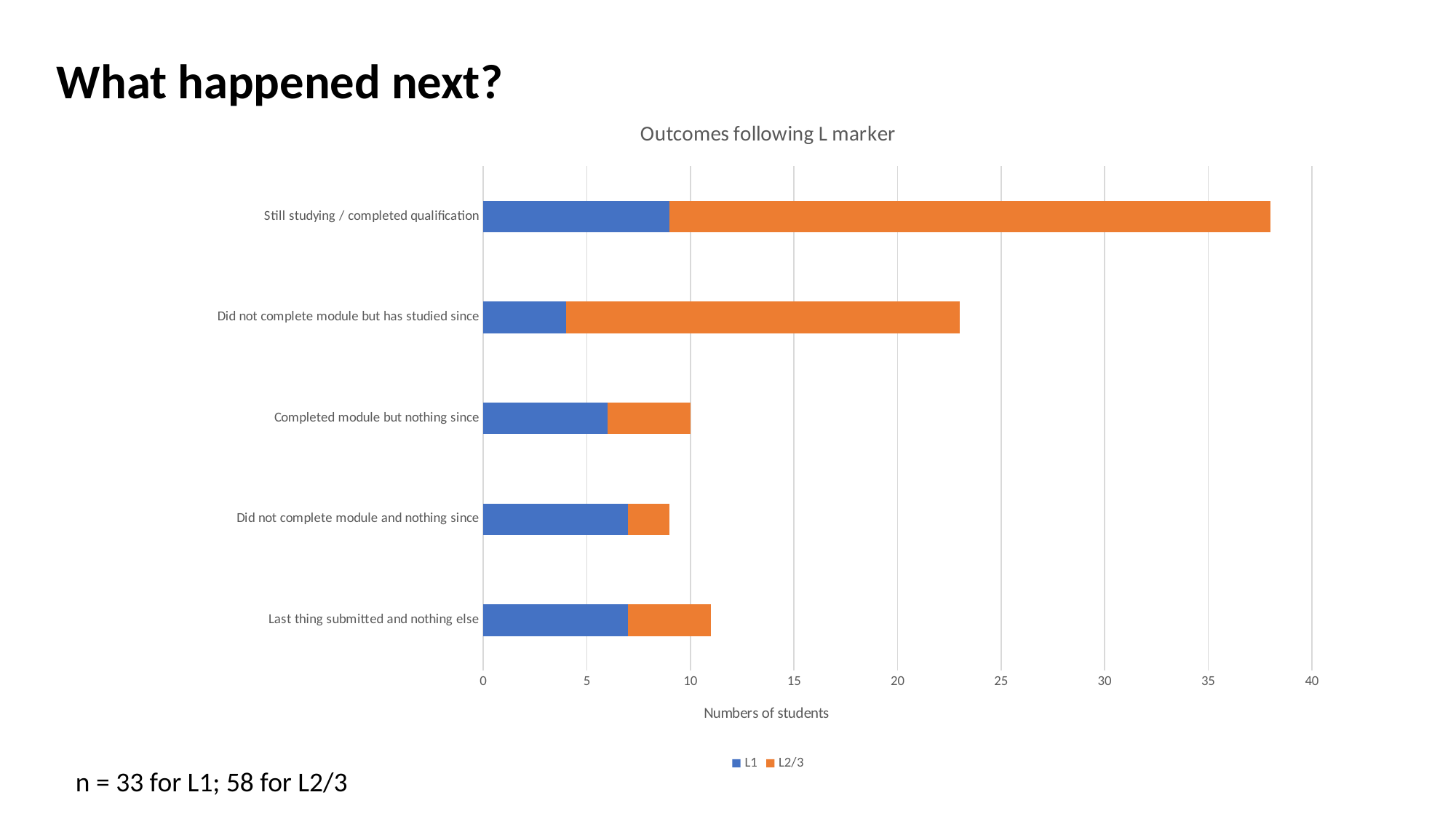
What kind of chart is shown on the slide? bar chart How many series does the legend list? 2 Which outcome category has the highest total number of students? Still studying / completed qualification What is the label on the horizontal axis of the chart? Numbers of students Is the total value for 'Still studying / completed qualification' greater or less than 35? greater How many outcome categories are plotted on the chart? 5 Is the L1 value for 'Did not complete module but has studied since' greater or less than 5? less Is the total value for 'Completed module but nothing since' greater or less than 15? less What is the title of the chart? Outcomes following L marker Which series is larger for 'Still studying / completed qualification': L1 or L2/3? L2/3 Which has a larger total number of students: 'Still studying / completed qualification' or 'Did not complete module but has studied since'? Still studying / completed qualification